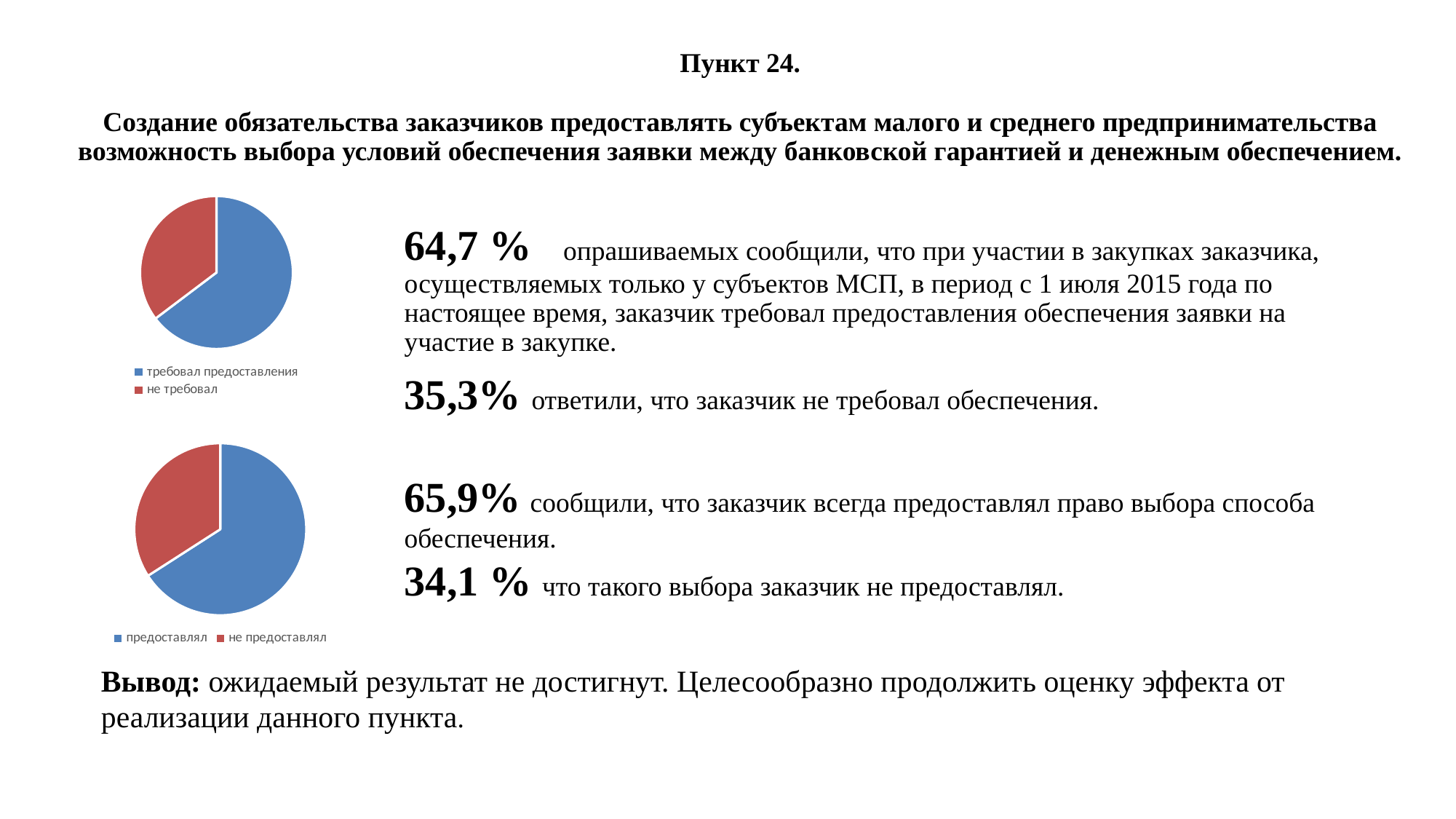
In the top pie chart, which category has the smallest slice? не требовал In the top pie chart, how many slices are there? 2 What kind of chart is the top chart on the slide? pie chart In the bottom pie chart, how many categories does the legend list? 2 In the bottom pie chart, what share of the pie does the slice 'не предоставлял' represent, according to the slide text? 34,1 % In the top pie chart, what colour is the slice for 'не требовал'? red In the bottom pie chart, is the slice 'предоставлял' larger or smaller than the slice 'не предоставлял'? larger In the bottom pie chart, which category has the smallest slice? не предоставлял In the bottom pie chart, which category has the largest slice? предоставлял In the top pie chart, what share of the pie does the slice 'требовал предоставления' represent, according to the slide text? 64,7 % What kind of chart is the bottom chart on the slide? pie chart In the top pie chart, which category has the largest slice? требовал предоставления